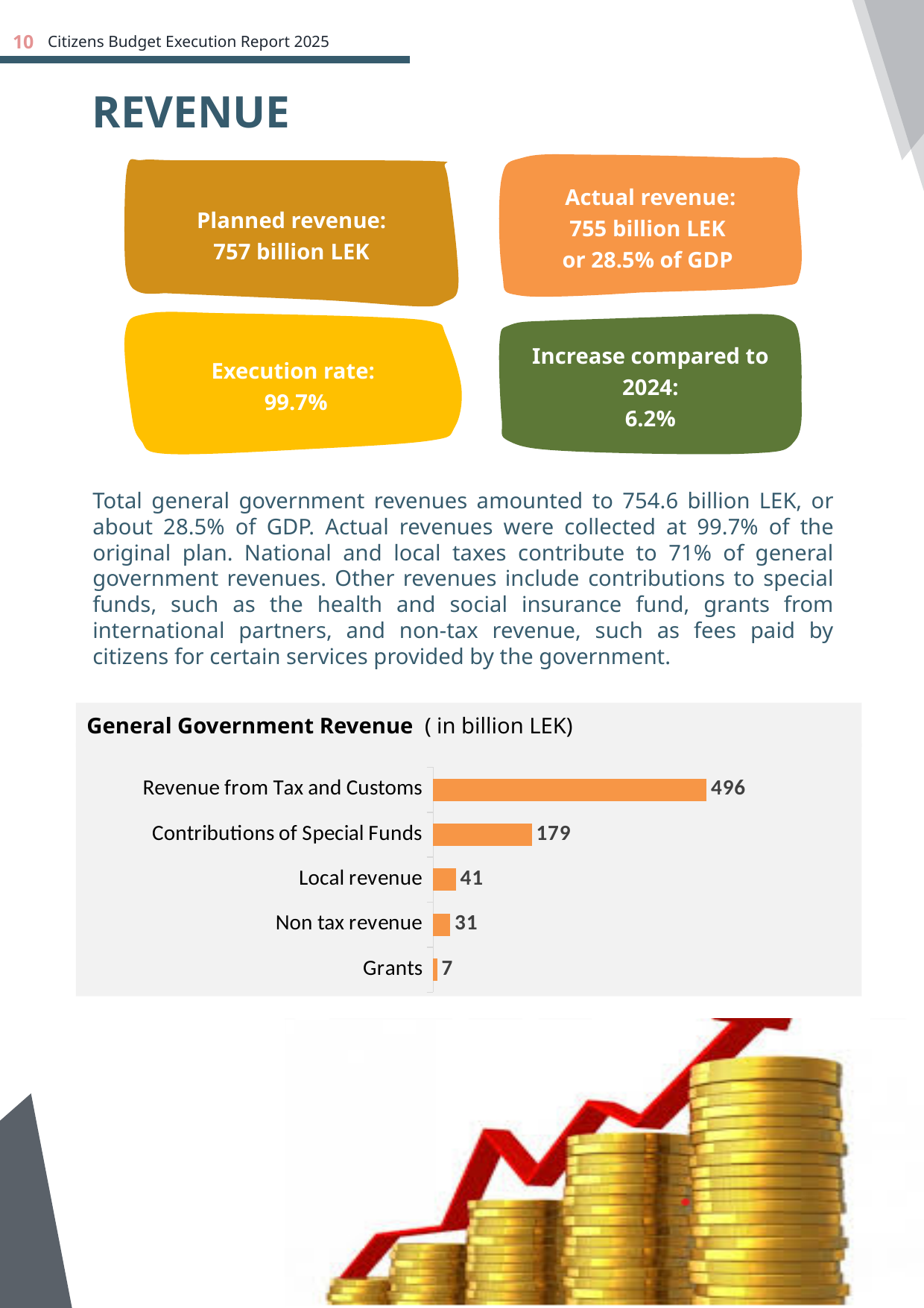
What is the difference between Revenue from Tax and Customs and Contributions of Special Funds in the General Government Revenue chart? 317 Which category has the highest value in the General Government Revenue chart? Revenue from Tax and Customs What is the value for Contributions of Special Funds in the General Government Revenue chart? 179 Which is larger in the General Government Revenue chart, Local revenue or Non tax revenue? Local revenue What is the value for Local revenue in the General Government Revenue chart? 41 What type of chart is the General Government Revenue chart? Bar chart What is the value for Non tax revenue in the General Government Revenue chart? 31 In what unit are the values in the General Government Revenue chart expressed? billion LEK What is the value for Grants in the General Government Revenue chart? 7 How many categories are shown in the General Government Revenue chart? 5 Which category has the lowest value in the General Government Revenue chart? Grants What is the value for Revenue from Tax and Customs in the General Government Revenue chart? 496